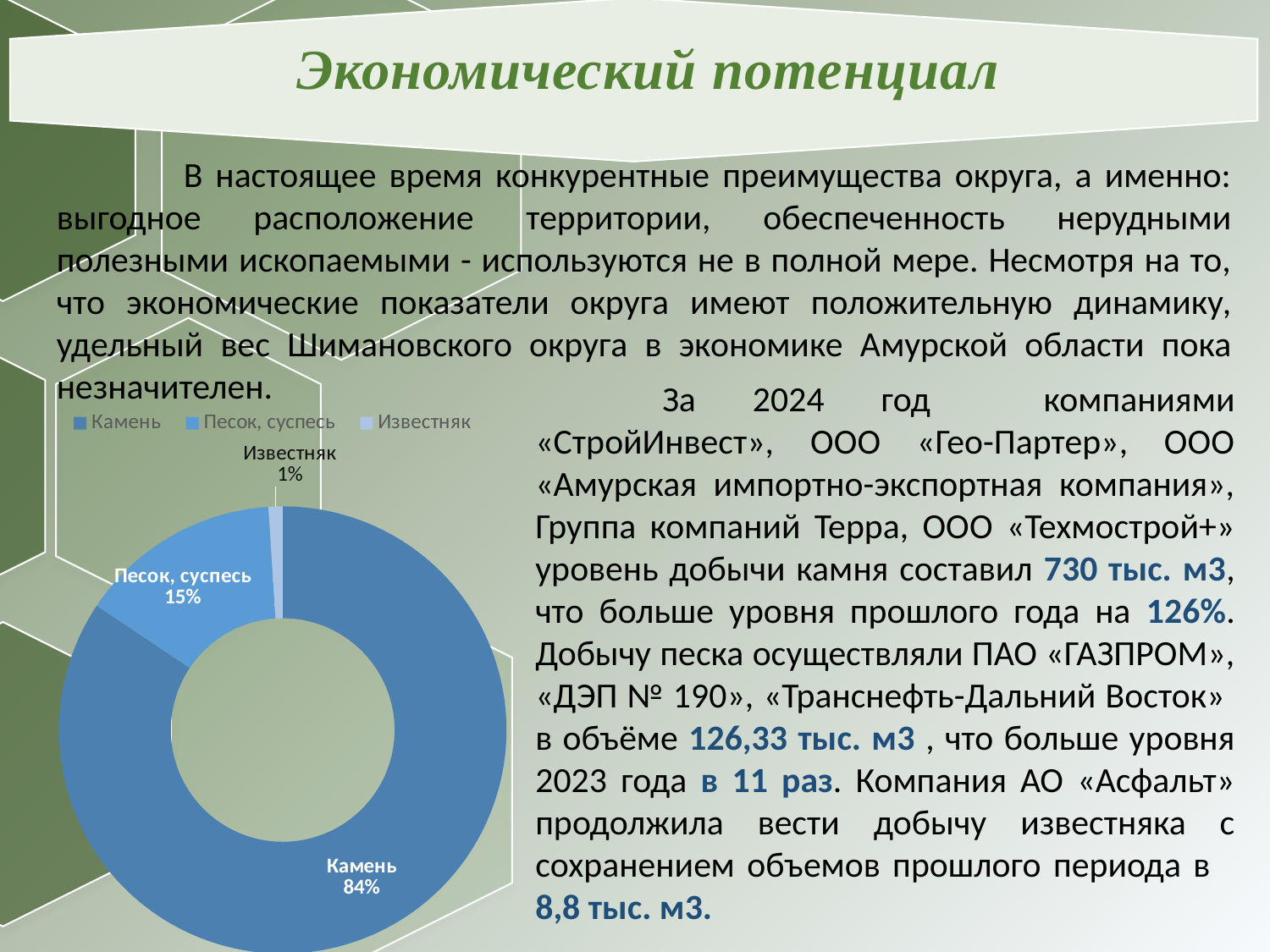
Which legend entry is listed first in the chart legend? Камень How many categories are shown in the doughnut chart? 3 What is the difference in percentage points between the shares of Камень and Песок, суспесь? 69 percentage points Which category has the smallest share in the doughnut chart? Известняк What share of the doughnut chart does Камень account for? 84% Which has a larger share in the doughnut chart, Песок, суспесь or Известняк? Песок, суспесь How many entries does the chart legend list? 3 What kind of chart is shown on the slide? Doughnut (pie) chart What share of the doughnut chart does Известняк account for? 1% What share of the doughnut chart does Песок, суспесь account for? 15% What is the difference in percentage points between the shares of Песок, суспесь and Известняк? 14 percentage points Which category has the largest share in the doughnut chart? Камень